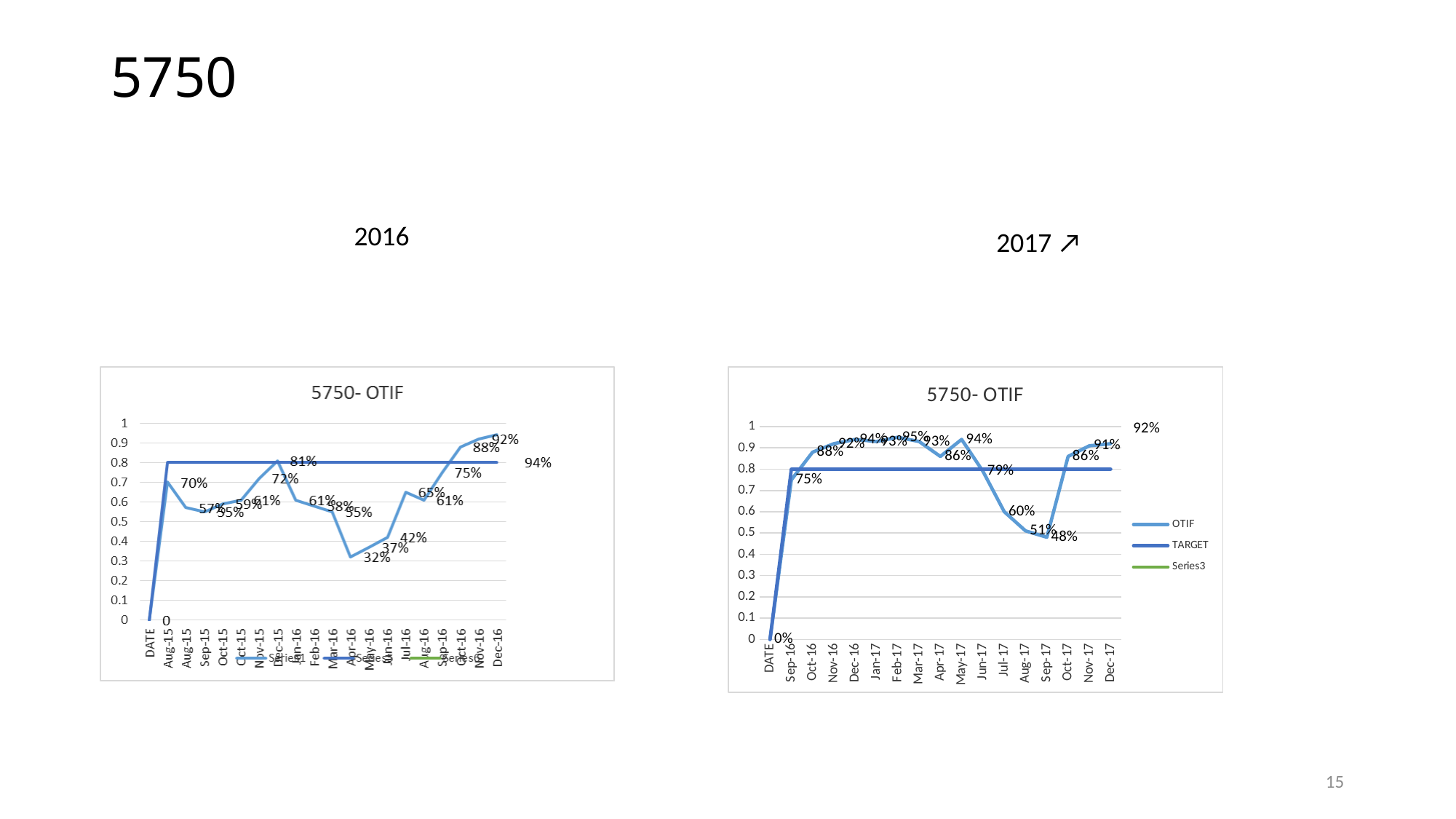
On the right chart (2017), which month from Sep-16 to Dec-17 has the lowest OTIF value? Sep-17 On the right chart (2017), how many series does the legend list? 3 On the right chart (2017), what is the OTIF value for Sep-17? 48% On the right chart (2017), what is the difference between the OTIF values for Jul-17 and Aug-17? 9 percentage points On the right chart (2017), is the OTIF value for Jun-17 greater or less than 0.8? less On the right chart (2017), what is the OTIF value for Jul-17? 60% On the left chart (2016), what is the lowest OTIF percentage labelled on the line? 32% On the right chart (2017), what is the OTIF value for Sep-16? 75% What kind of chart is the left chart (2016)? line chart On the left chart (2016), what is the OTIF value for Dec-15? 81% On the right chart (2017), do the OTIF values rise or fall from Jun-17 to Sep-17? fall